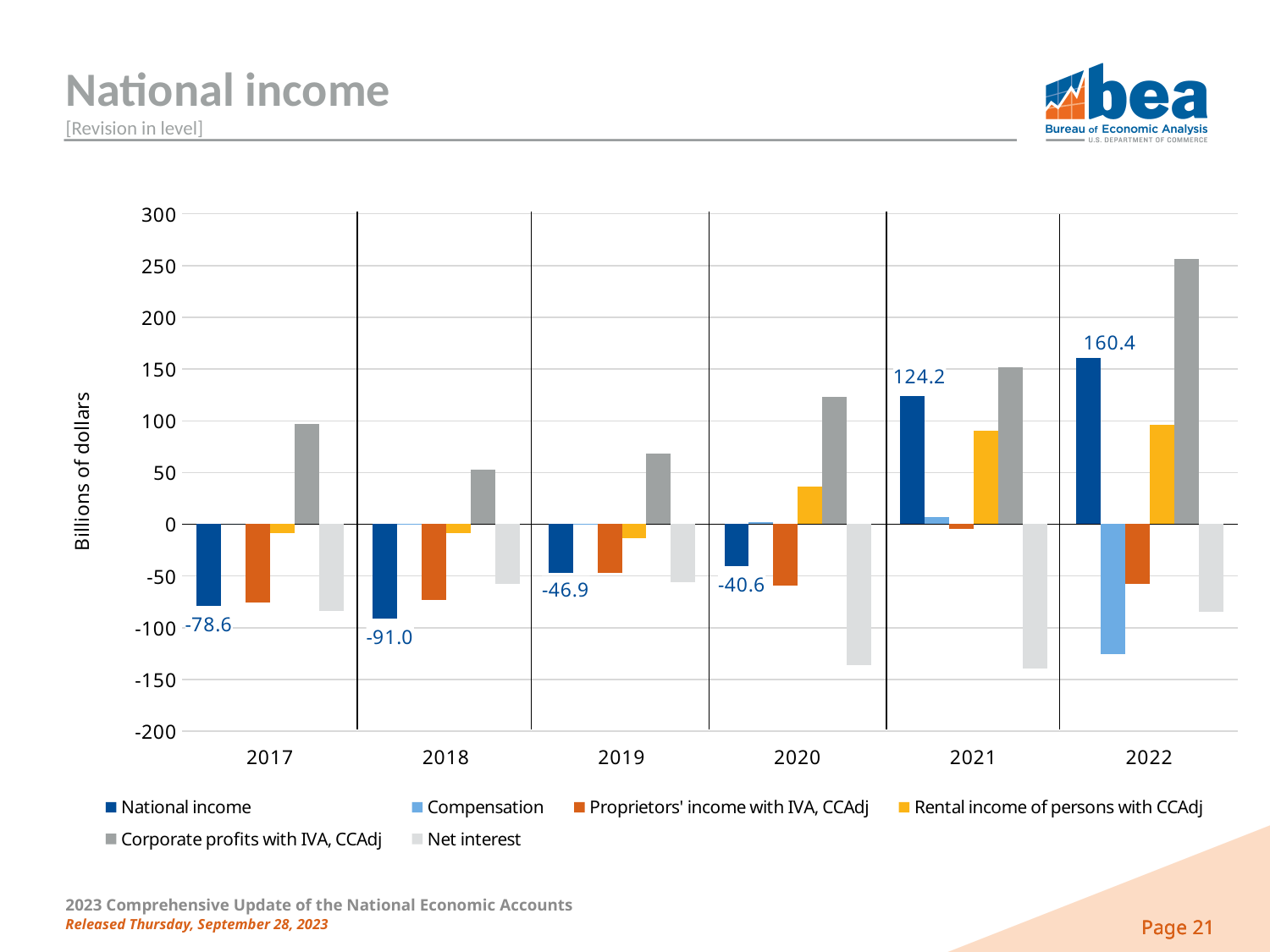
Is the value for Corporate profits with IVA, CCAdj in 2022 greater or less than 200? greater Is the value for Net interest in 2020 greater or less than -100? less How many years are shown on the x axis? 6 In which year is the National income revision lowest? 2018 Which year has the larger National income value, 2019 or 2020? 2020 What kind of chart is shown on the slide? bar chart What is the value for National income in 2017? -78.6 What is the value for National income in 2022? 160.4 What is the difference between the National income values for 2022 and 2021? 36.2 In which year is the National income revision highest? 2022 How many series does the legend list? 6 What is the label on the y axis? Billions of dollars